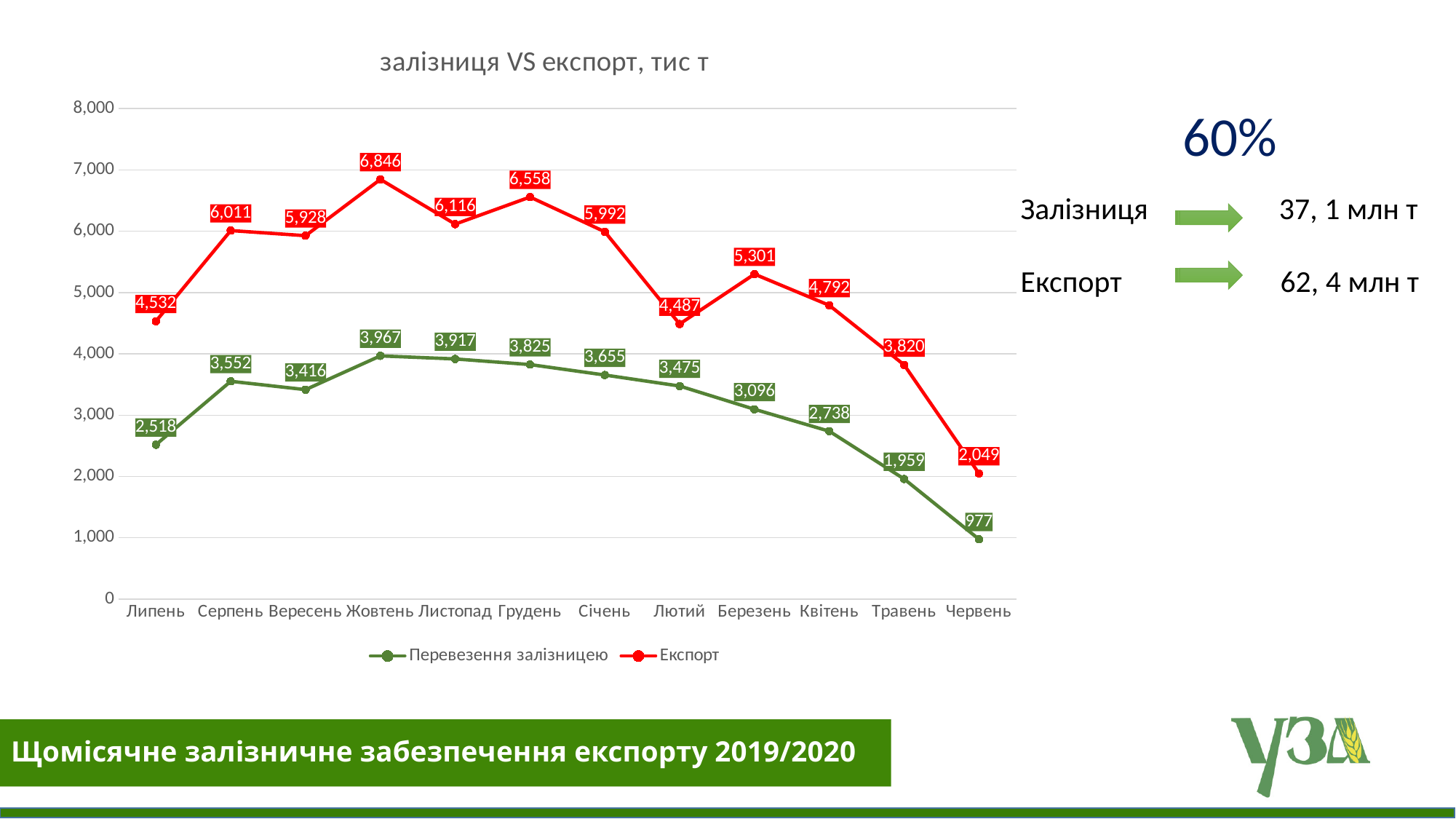
How many months are shown on the x axis? 12 What is the value of Перевезення залізницею in Червень? 977 In which month is Експорт highest? Жовтень What is the value of Експорт in Січень? 5,992 Which month has the larger Експорт value, Лютий or Березень? Березень What is the difference between Експорт and Перевезення залізницею in Жовтень? 2,879 How many series does the legend list? 2 Does Перевезення залізницею rise or fall from Жовтень to Червень? fall What kind of chart is shown on the slide? line chart What is the value of Експорт in Жовтень? 6,846 What is the difference between Експорт in Серпень and Експорт in Вересень? 83 In which month is Перевезення залізницею lowest? Червень